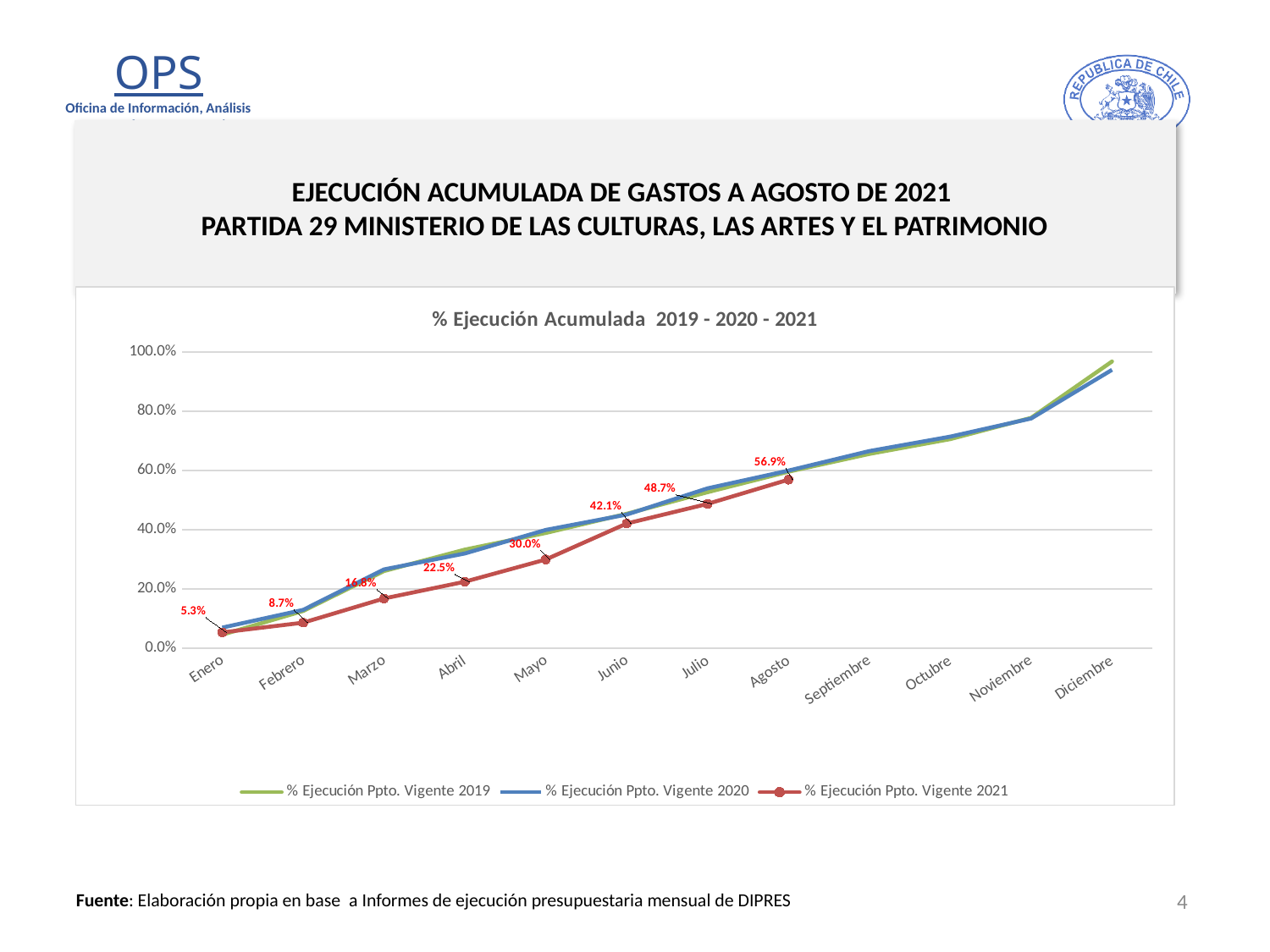
How many months are shown on the x axis? 12 What is the value for % Ejecución Ppto. Vigente 2021 in Mayo? 30.0% What is the value for % Ejecución Ppto. Vigente 2021 in Enero? 5.3% Which month has the highest value for % Ejecución Ppto. Vigente 2021? Agosto Do the values for % Ejecución Ppto. Vigente 2021 rise or fall from Enero to Agosto? rise What type of chart is shown on the slide? line chart How many series does the legend list? 3 What is the title of the chart? % Ejecución Acumulada 2019 - 2020 - 2021 Is the value for % Ejecución Ppto. Vigente 2020 in Noviembre greater or less than 60.0%? greater What is the difference between the 2021 values for Agosto and Julio? 8.2% Which month has the lowest value for % Ejecución Ppto. Vigente 2021? Enero What is the value for % Ejecución Ppto. Vigente 2021 in Agosto? 56.9%